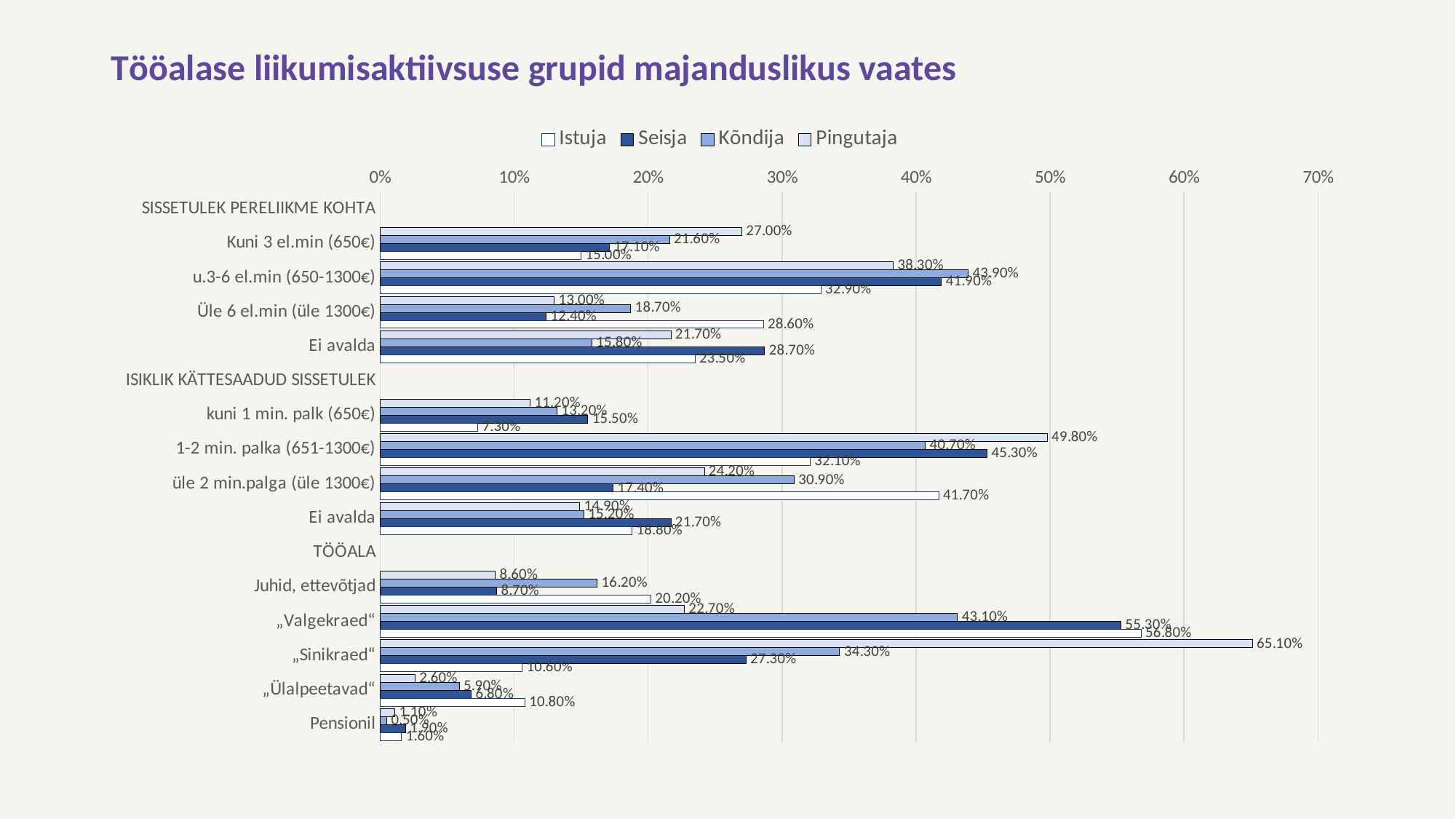
What is the Istuja value for „Valgekraed“? 56.80% What is the Kõndija value for u.3-6 el.min (650-1300€)? 43.90% What is the Seisja value for 1-2 min. palka (651-1300€)? 45.30% What is the Pingutaja value for „Sinikraed“? 65.10% How many series does the legend list? 4 Which is larger for Üle 6 el.min (üle 1300€): the Istuja value or the Pingutaja value? Istuja Is the Istuja value for üle 2 min.palga (üle 1300€) greater or less than 40%? greater Which category has the highest Pingutaja value? „Sinikraed“ What kind of chart is shown on the slide? bar chart Which category has the lowest Kõndija value? Pensionil What is the difference between the Pingutaja and Kõndija values for „Sinikraed“? 30.80% How many categories are listed under the TÖÖALA group? 5